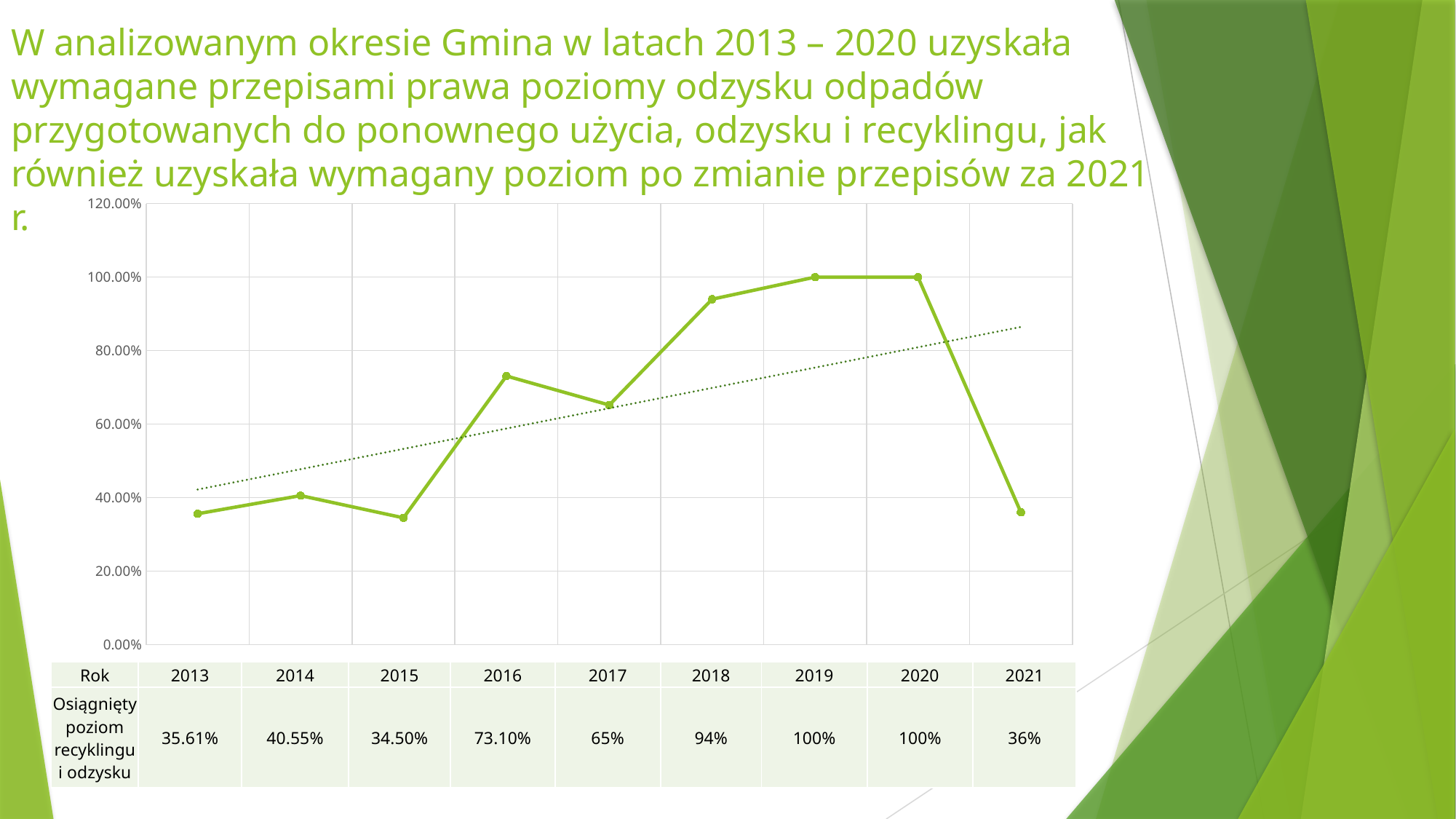
Is the value for 2018 greater or less than 80.00%? greater What was the achieved level of recycling and recovery (Osiągnięty poziom recyklingu i odzysku) in 2016? 73.10% How many years (data points) are plotted in the chart? 9 What type of chart is shown on the slide? line chart What is the name of the data series shown in the table below the chart? Osiągnięty poziom recyklingu i odzysku What value is shown for the year 2021? 36% Which is larger, the value for 2014 or the value for 2015? 2014 What value is shown for the year 2013? 35.61% What is the highest value reached in the chart, and in which years? 100% in 2019 and 2020 Which year has the lowest achieved level of recycling and recovery? 2015 What is the difference between the values for 2018 and 2017? 29% Does the value rise or fall from 2020 to 2021? fall